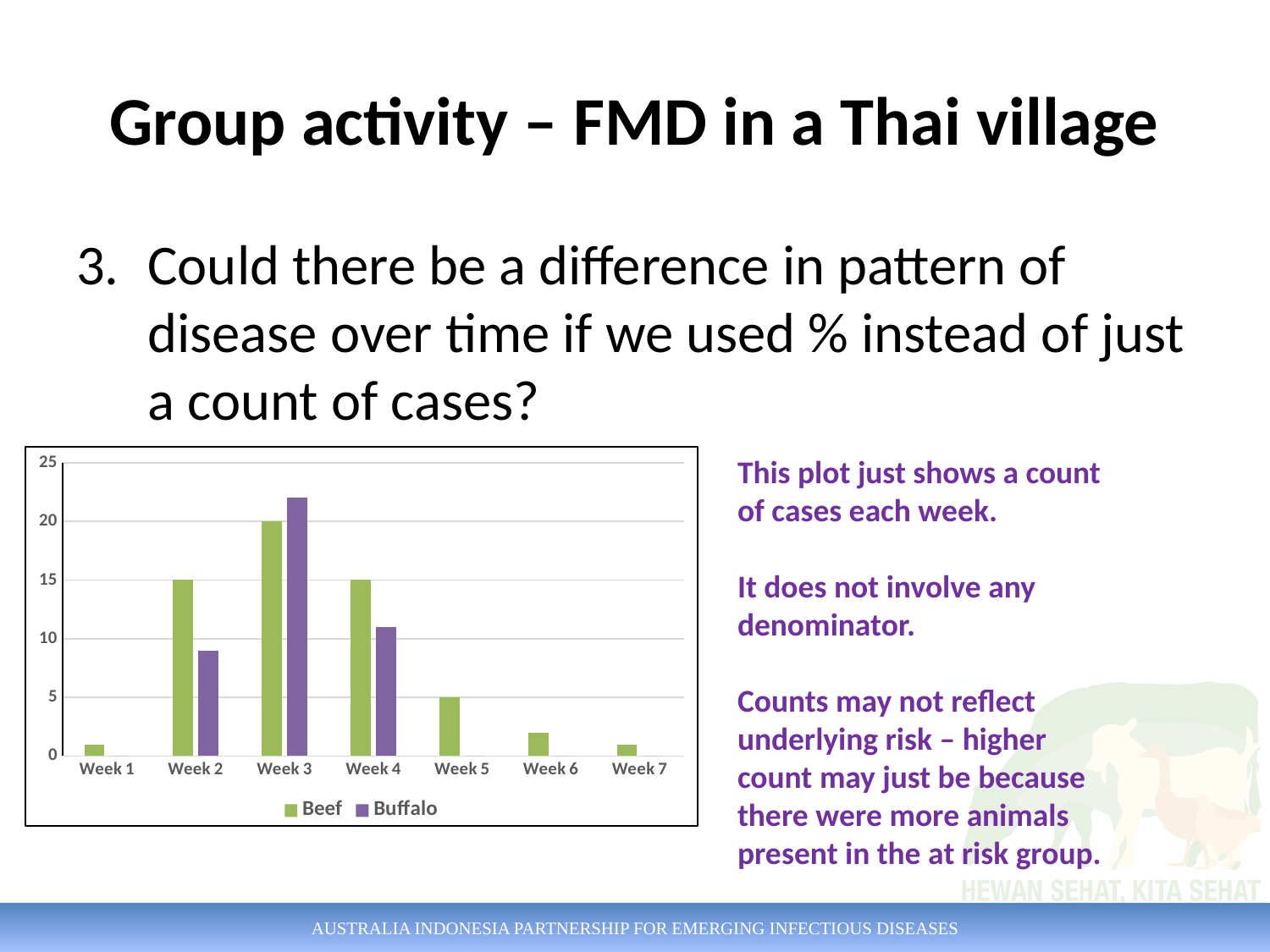
What is the Beef value for Week 2? 15 What is the difference between the Beef values for Week 3 and Week 5? 15 What is the Beef value for Week 5? 5 How many weeks are shown on the x axis of the chart? 7 What is the Beef value for Week 3? 20 Is the Buffalo value for Week 2 greater or less than 10? less In which week is the Buffalo count highest? Week 3 Is the Buffalo value for Week 3 greater or less than 20? greater In which week is the Beef count highest? Week 3 In Week 4, which series has the larger value, Beef or Buffalo? Beef How many series does the chart's legend list? 2 What kind of chart is shown on the slide? bar chart